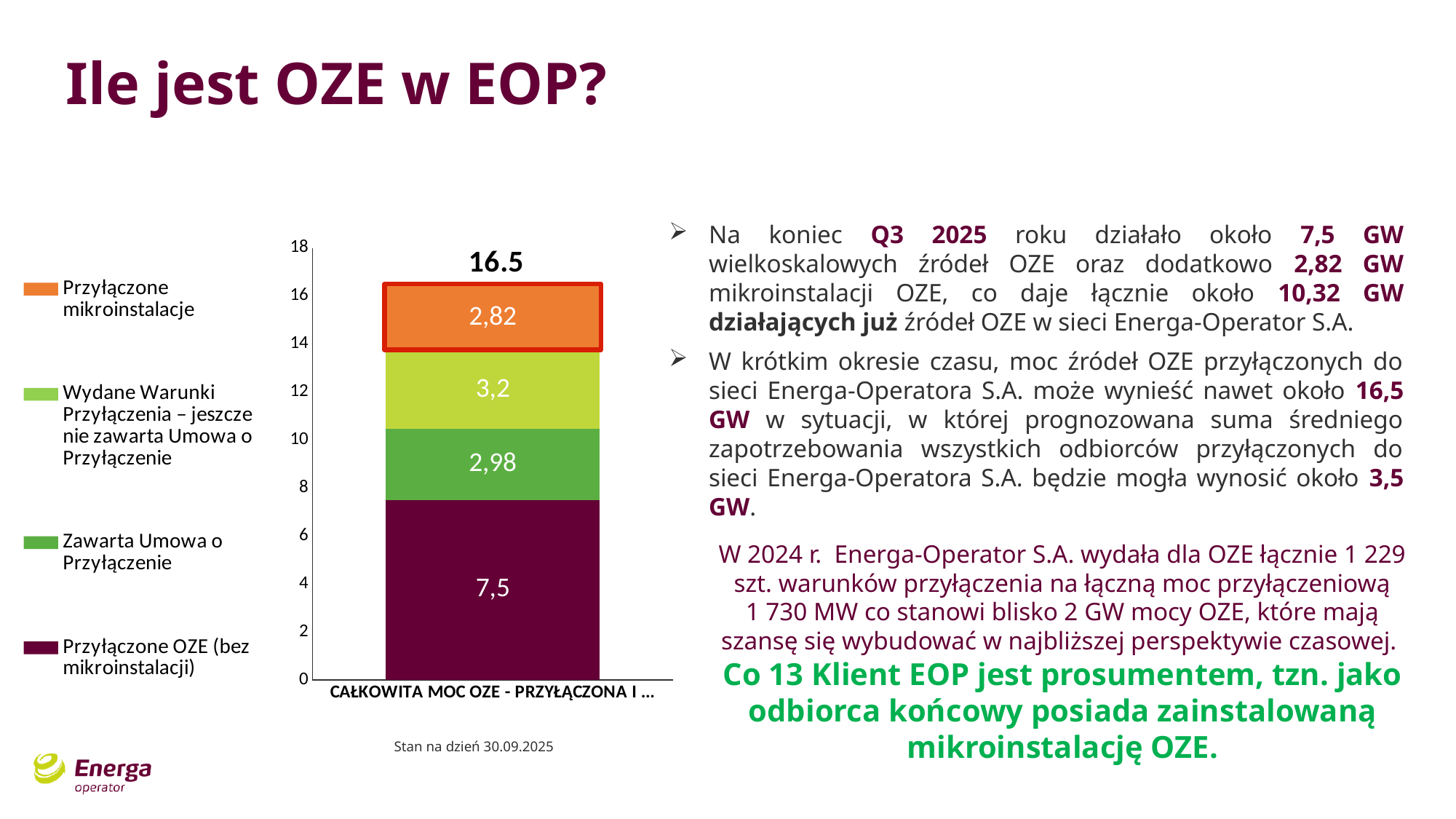
What is the value of the "Wydane Warunki Przyłączenia – jeszcze nie zawarta Umowa o Przyłączenie" segment in the stacked bar? 3,2 What colour is the "Przyłączone mikroinstalacje" segment in the chart? Orange Which is larger: the "Wydane Warunki Przyłączenia" segment or the "Zawarta Umowa o Przyłączenie" segment? Wydane Warunki Przyłączenia What kind of chart is shown on the slide? Stacked bar chart What is the value of the "Zawarta Umowa o Przyłączenie" segment in the stacked bar? 2,98 What is the value of the "Przyłączone OZE (bez mikroinstalacji)" segment in the stacked bar? 7,5 How many series does the legend list? 4 Which series has the largest segment in the stacked bar? Przyłączone OZE (bez mikroinstalacji) What is the difference between the "Przyłączone OZE (bez mikroinstalacji)" segment and the "Przyłączone mikroinstalacje" segment? 4,68 What total is printed above the stacked bar? 16.5 Which series has the smallest segment in the stacked bar? Przyłączone mikroinstalacje What is the value of the "Przyłączone mikroinstalacje" segment in the stacked bar? 2,82